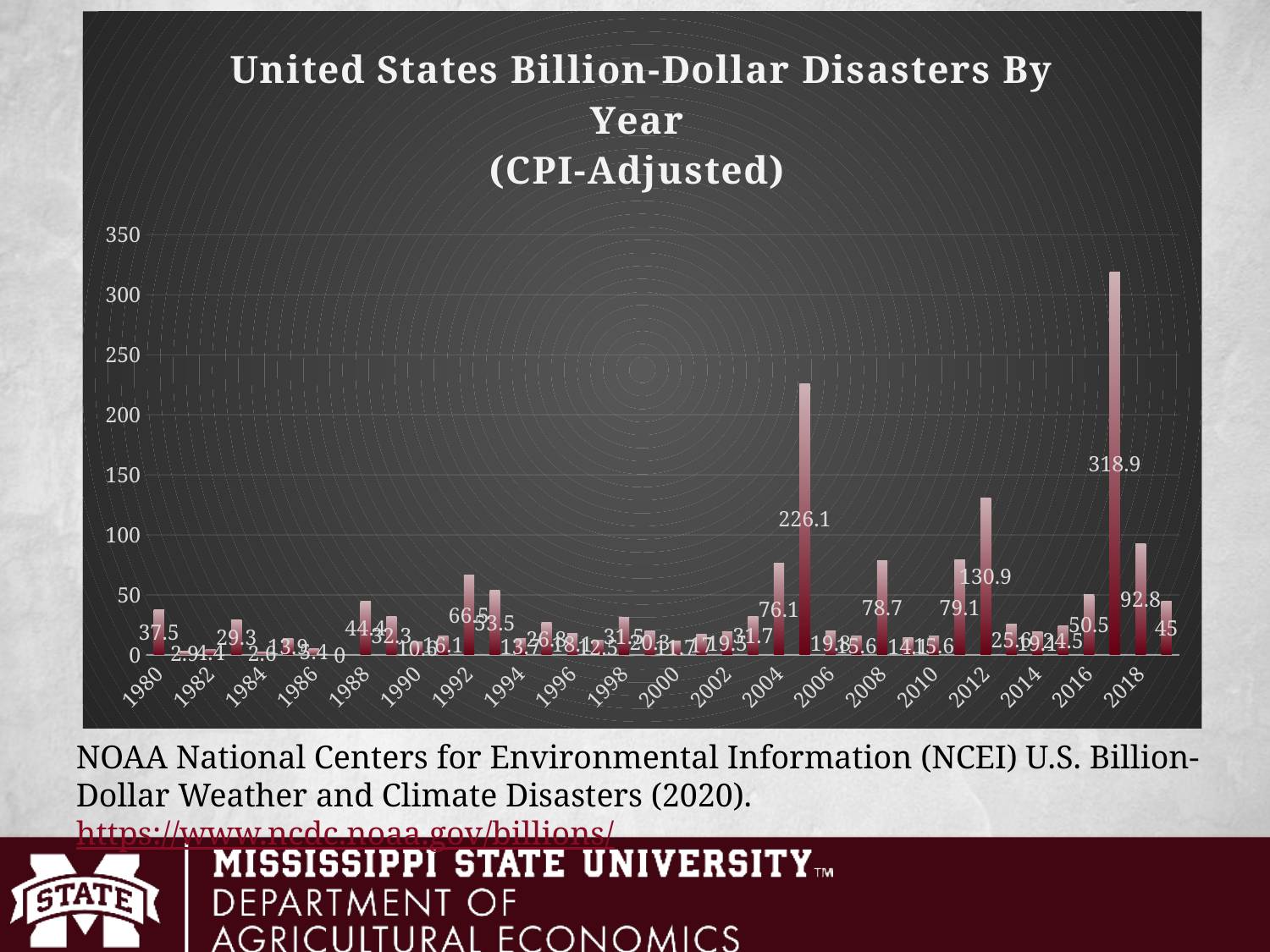
What is the title of the chart? United States Billion-Dollar Disasters By Year (CPI-Adjusted) Is the value for 2005 greater or less than 200? greater What is the value for 2017? 318.9 What is the difference between the values for 2017 and 2005? 92.8 What is the value for 2012? 130.9 What is the value for 1980? 37.5 What is the value for 2005? 226.1 Which year has the highest value? 2017 Which is larger, the value for 2012 or the value for 2018? 2012 What kind of chart is shown on the slide? bar chart Is the value for 2011 greater or less than 100? less What is the value for 2018? 92.8